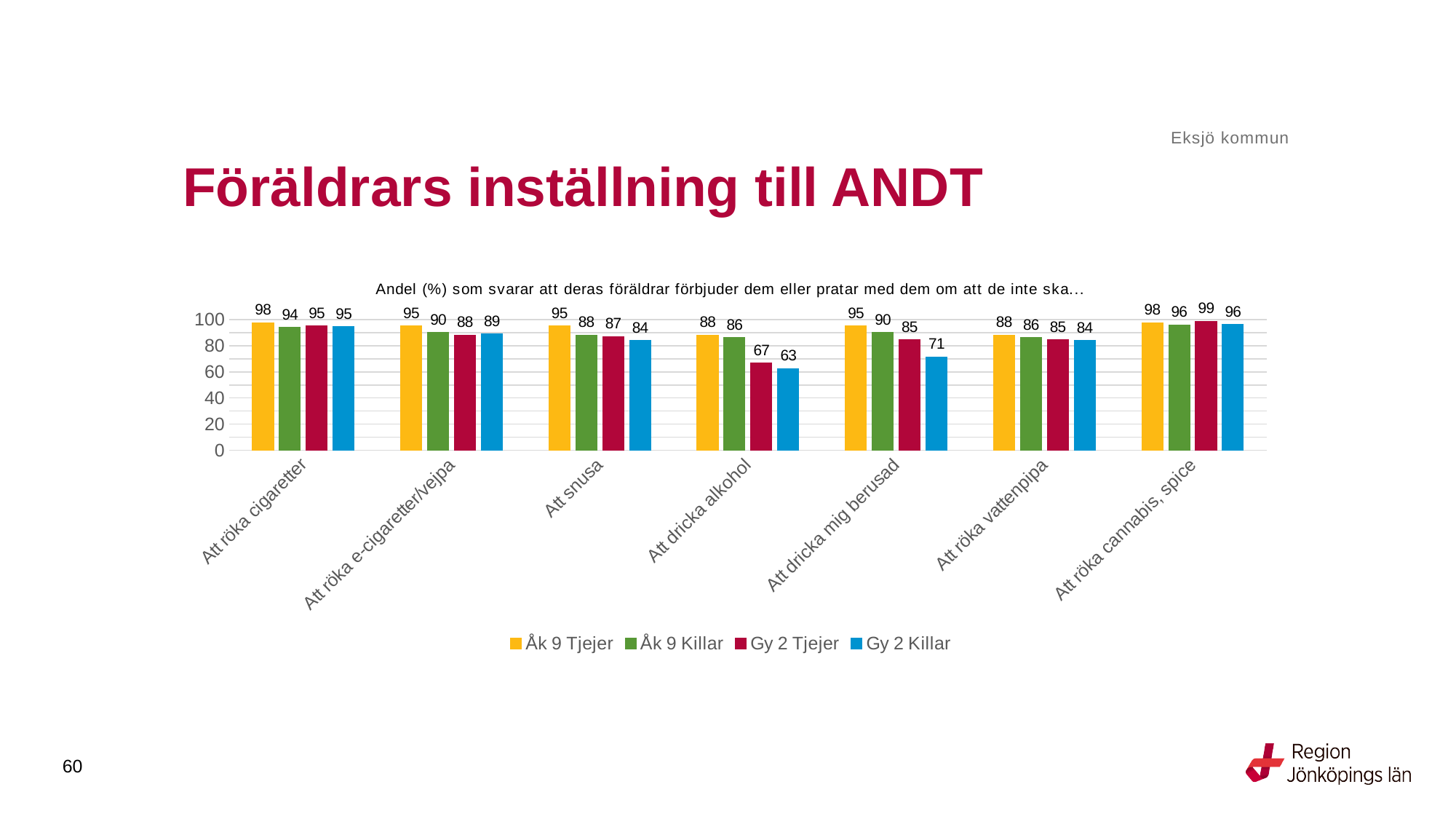
How many categories are shown on the x axis? 7 What is the difference between Åk 9 Tjejer and Gy 2 Killar in the category "Att dricka mig berusad"? 24 Which category has the highest value for Gy 2 Tjejer? Att röka cannabis, spice In the category "Att snusa", which is larger: Åk 9 Killar or Gy 2 Killar? Åk 9 Killar Which series is shown in blue in the legend? Gy 2 Killar What is the value for Åk 9 Tjejer in the category "Att röka e-cigaretter/vejpa"? 95 Which category has the lowest value for Gy 2 Killar? Att dricka alkohol What is the value for Gy 2 Tjejer in the category "Att röka cannabis, spice"? 99 How many series does the legend list? 4 What is the value for Gy 2 Killar in the category "Att dricka alkohol"? 63 What kind of chart is shown on the slide? bar chart Is the value for Gy 2 Tjejer in "Att dricka alkohol" greater or less than 80? less